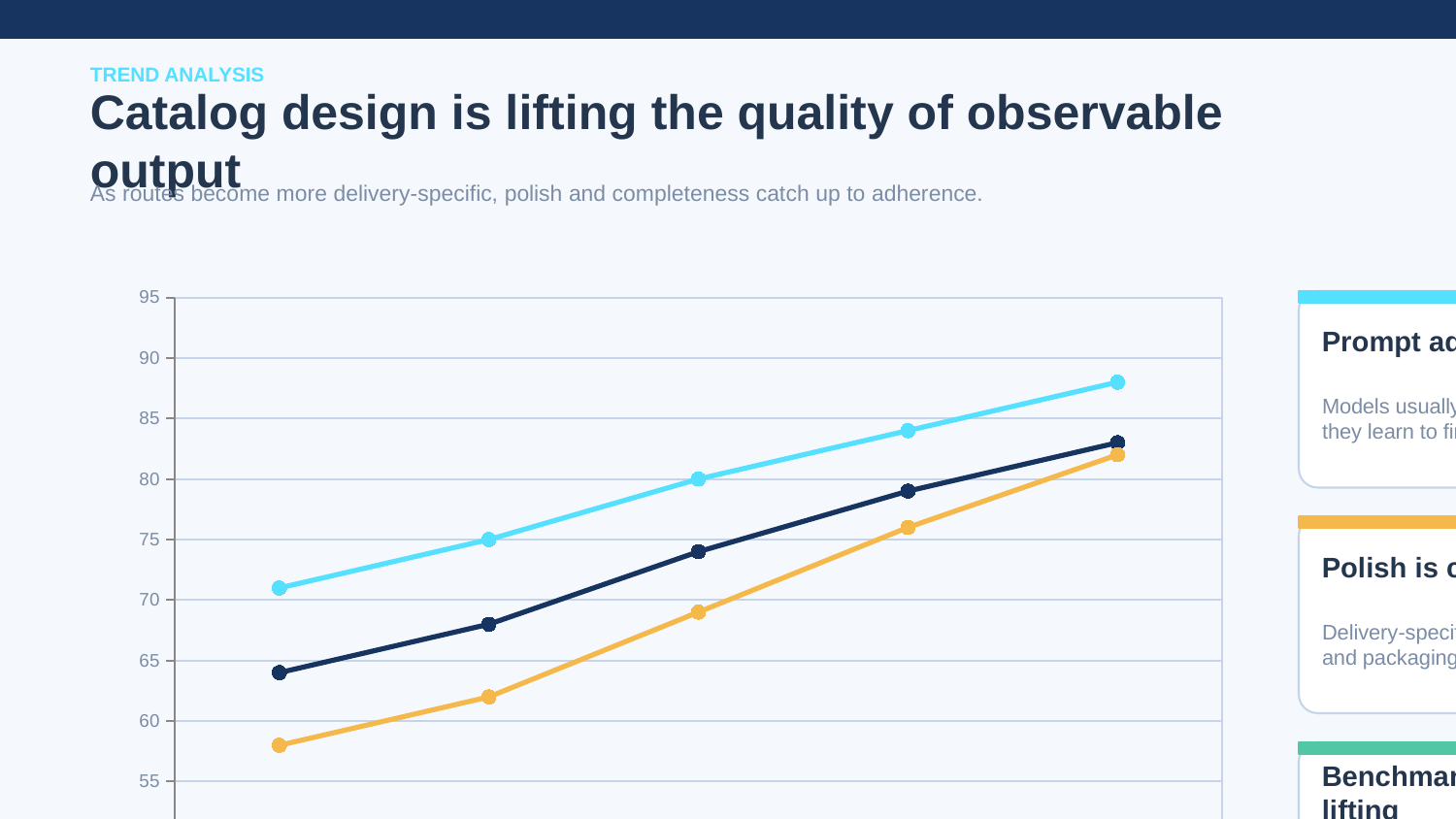
Is the value of the orange line at its first point greater or less than 60? less What is the title of the slide containing the chart? Catalog design is lifting the quality of observable output How many lines are plotted on the chart? 3 Which line has the lowest value at the first point: the light blue, dark navy or orange line? orange Is the value of the light blue line at its last point greater or less than 85? greater Is the value of the orange line at its last point greater or less than 80? greater Which line is the highest across the whole chart: the light blue, dark navy or orange line? light blue How many data points does each line on the chart have? 5 Do the values of the light blue line rise or fall from left to right? rise Do the values of the orange line rise or fall from left to right? rise At the last point, which line has the larger value: the light blue line or the dark navy line? light blue What kind of chart is shown on the slide? line chart